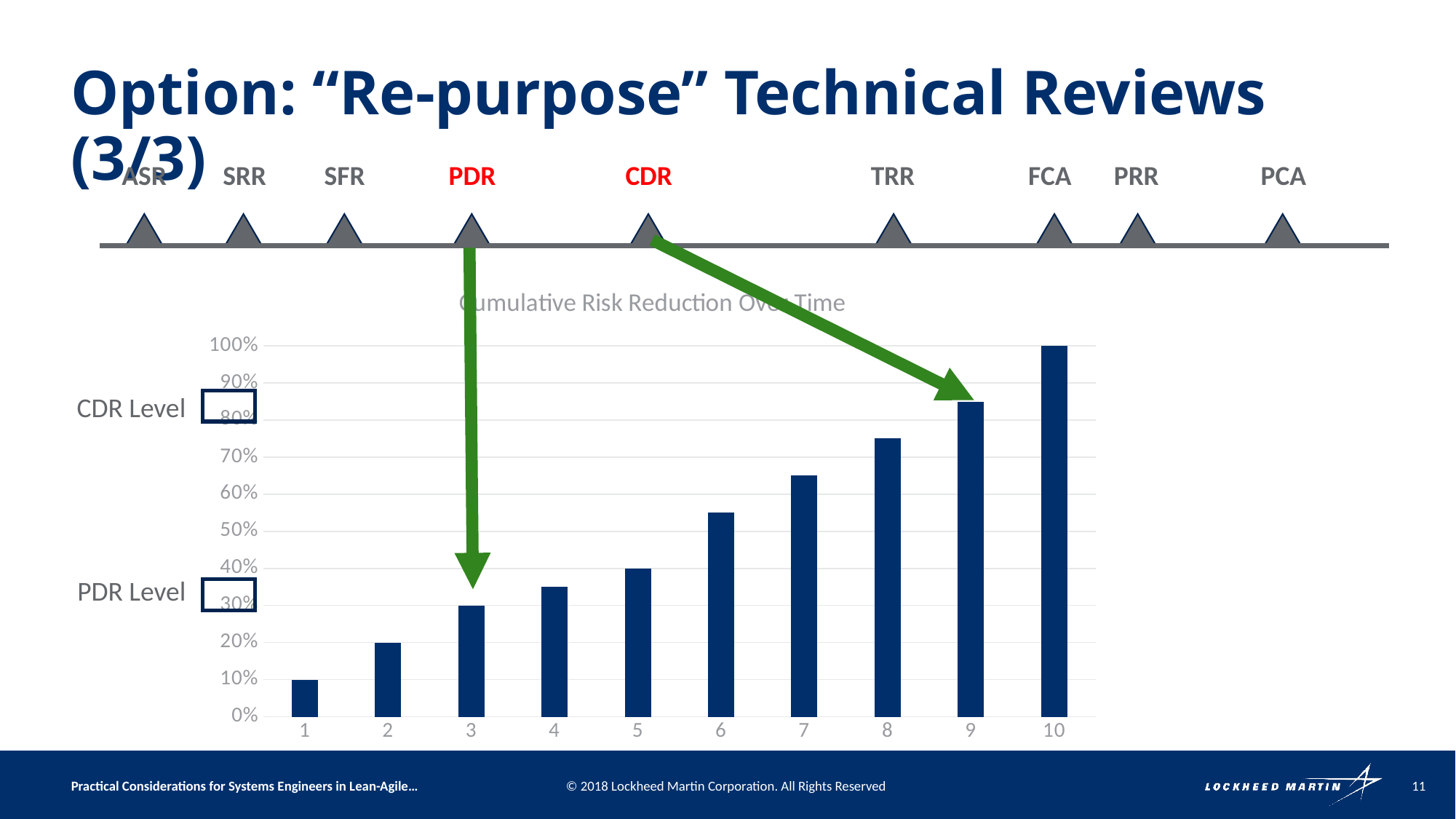
Which category has the highest bar in the chart? 10 What is the title of the chart? Cumulative Risk Reduction Over Time Is the value for category 7 greater or less than 60%? greater What kind of chart is shown on the slide? bar chart Which category has the lowest bar in the chart? 1 Do the values rise or fall from category 1 to category 10? rise What is the value for category 2 in the chart? 20% Is the value for category 4 greater or less than 40%? less What is the value for category 10 in the chart? 100% Which category has the larger value, 8 or 6? 8 What is the value for category 1 in the chart? 10% How many categories are plotted along the x axis of the chart? 10